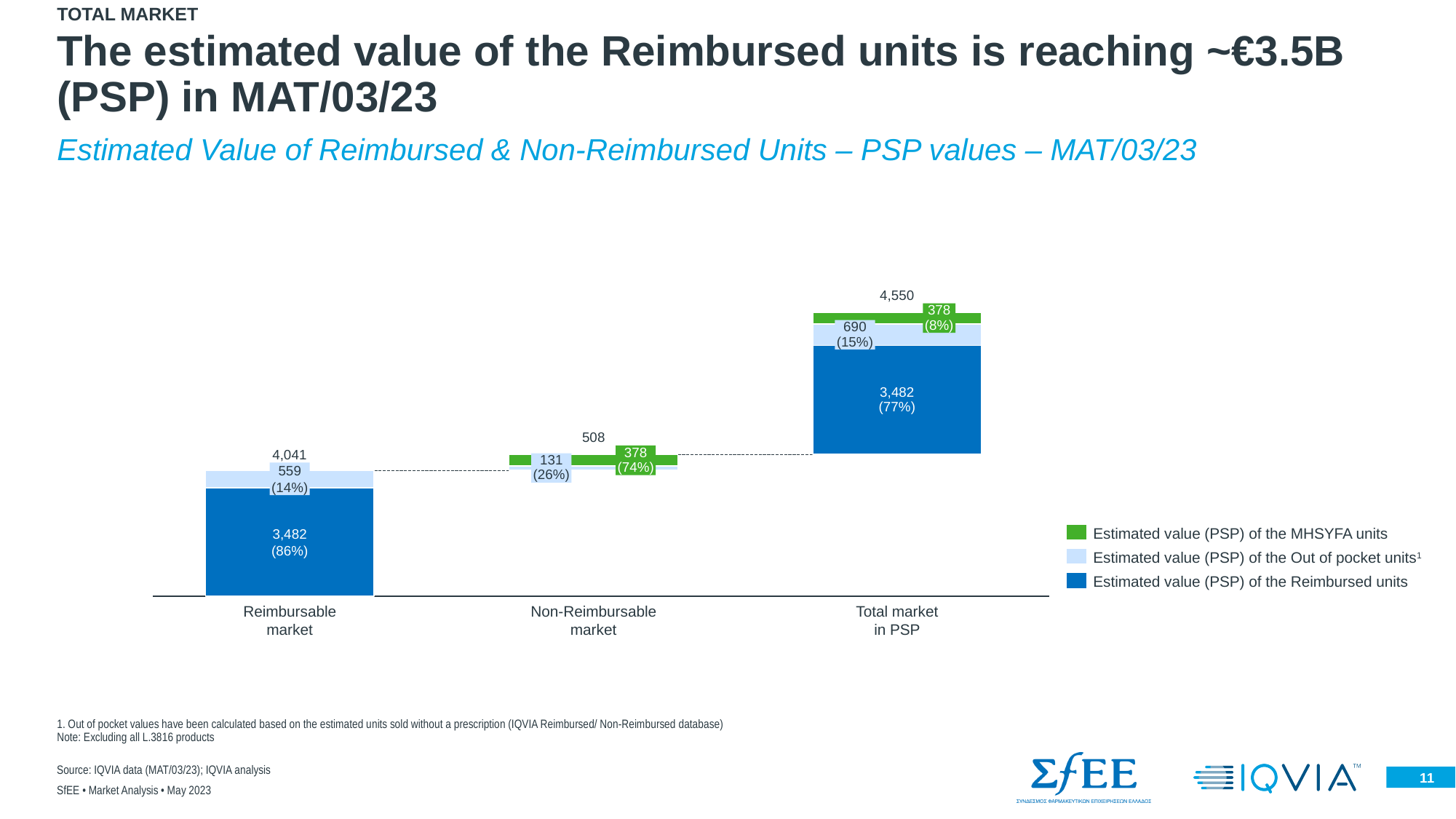
What is the total value shown above the Non-Reimbursable market bar? 508 What kind of chart is shown on the slide? Stacked bar chart Which category has the lowest total value? Non-Reimbursable market What is the estimated value (PSP) of the Reimbursed units in the Reimbursable market? 3,482 Which is larger: the Out of pocket value in the Reimbursable market or the Out of pocket value in the Non-Reimbursable market? Reimbursable market What is the estimated value (PSP) of the MHSYFA units in the Non-Reimbursable market? 378 Which category has the highest total value? Total market in PSP How many series does the legend list? 3 What is the difference between the total of the Total market in PSP and the total of the Reimbursable market? 509 What is the total value shown above the Total market in PSP bar? 4,550 What is the estimated value (PSP) of the Out of pocket units in the Total market in PSP? 690 How many categories are shown on the x axis? 3